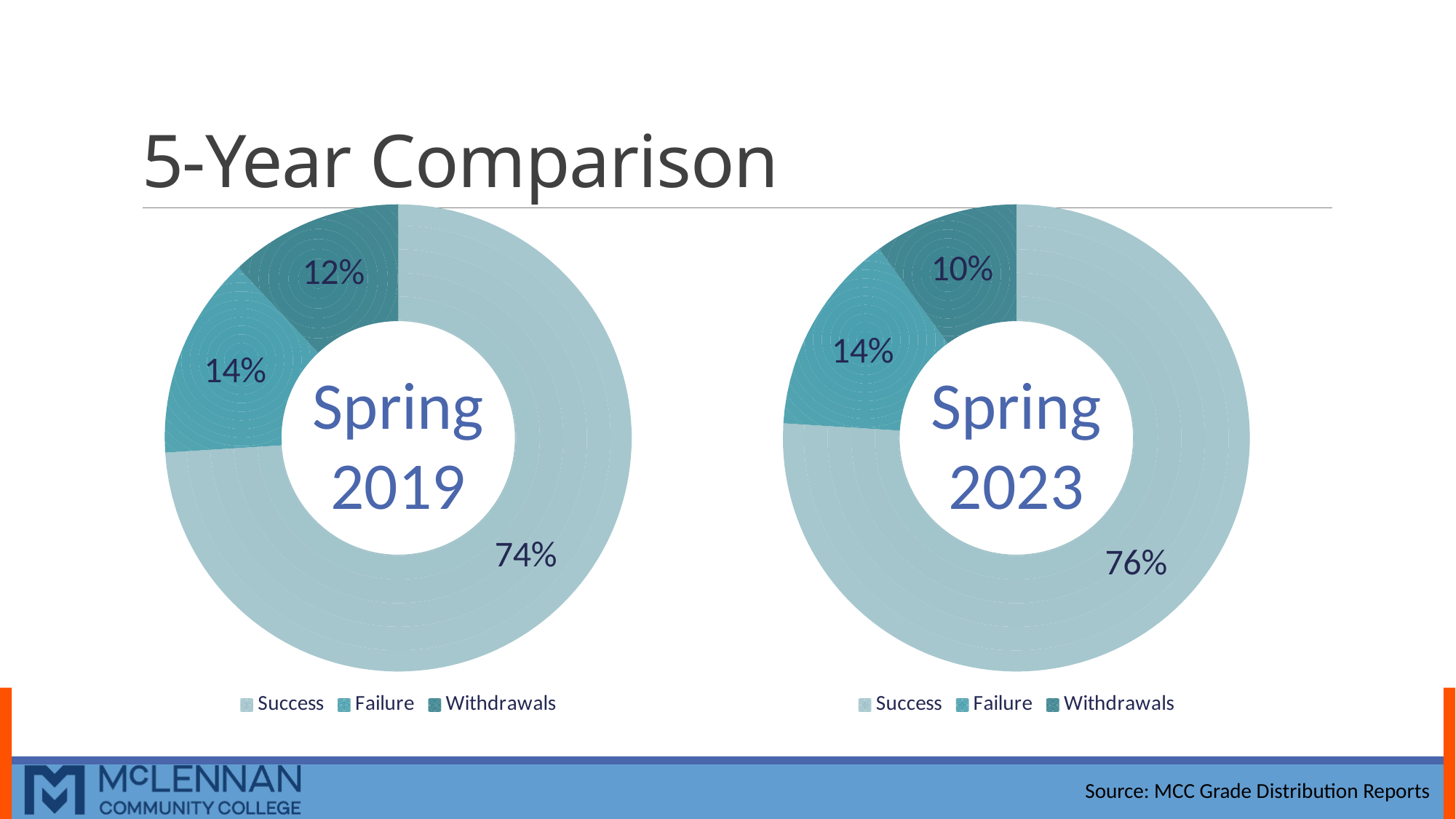
In the Spring 2019 chart, what percentage is shown for Withdrawals? 12% Which is larger: the Withdrawals share in Spring 2019 or the Withdrawals share in Spring 2023? Spring 2019 In the Spring 2023 chart, which category has the smallest share? Withdrawals In the Spring 2019 chart, what percentage is shown for Success? 74% In the Spring 2019 chart, what is the difference between the Failure share and the Withdrawals share? 2% What is the difference between the Success share in Spring 2023 and the Success share in Spring 2019? 2% How many categories does the legend of the Spring 2023 chart list? 3 In the Spring 2023 chart, what percentage is shown for Failure? 14% In the Spring 2023 chart, what percentage is shown for Withdrawals? 10% In the Spring 2019 chart, which category has the largest share? Success What kind of chart is used for the Spring 2019 data? Doughnut (pie) chart What is the title of the slide containing the two charts? 5-Year Comparison